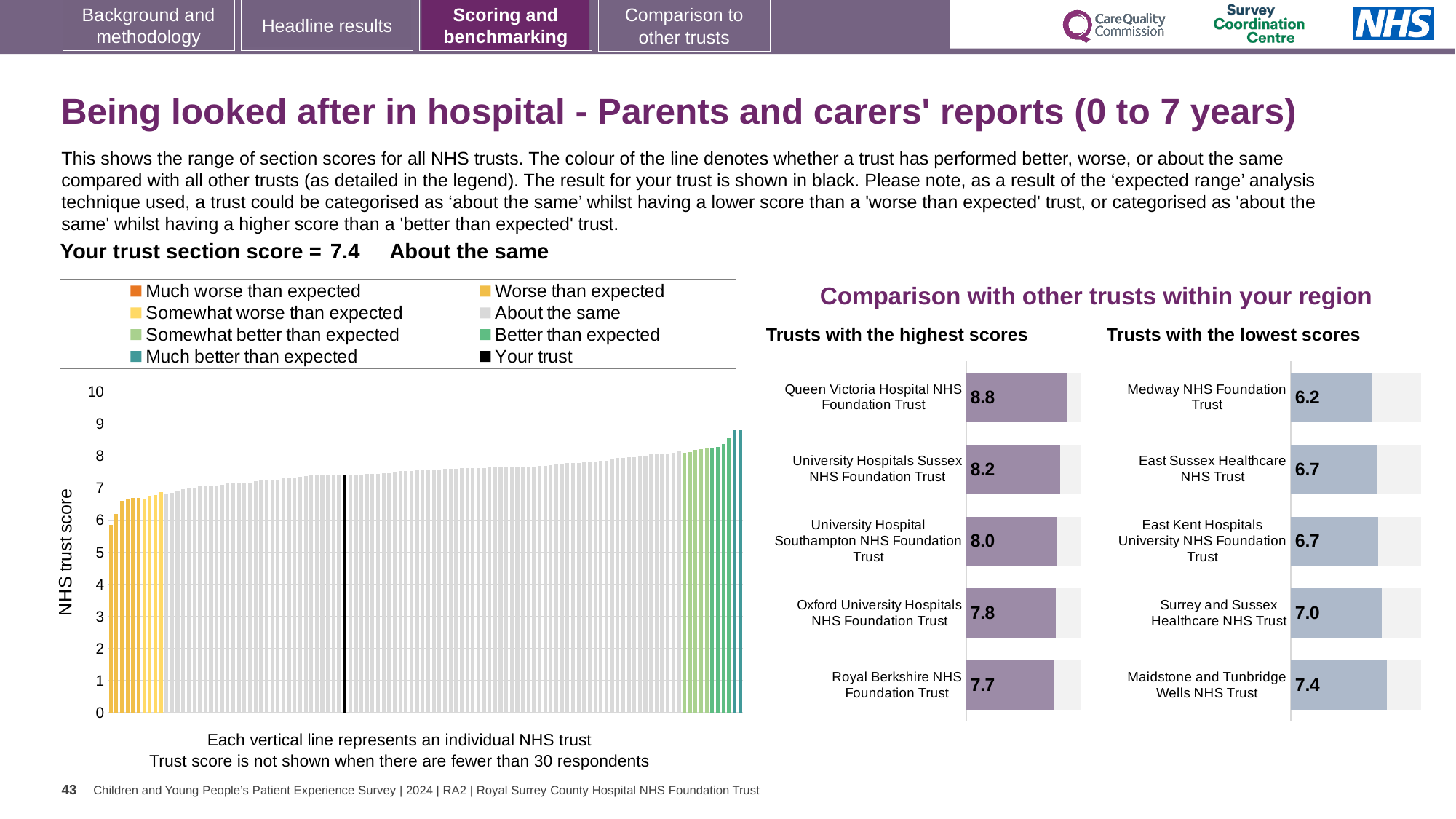
In the 'Trusts with the highest scores' chart, what is the score for Queen Victoria Hospital NHS Foundation Trust? 8.8 In the NHS trust score chart on the left, what is the section score for your trust (the black line)? 7.4 How many entries does the legend of the NHS trust score chart on the left list? 8 In the 'Trusts with the lowest scores' chart, what is the score for East Kent Hospitals University NHS Foundation Trust? 6.7 In the 'Trusts with the lowest scores' chart, what is the score for Medway NHS Foundation Trust? 6.2 What kind of chart is the NHS trust score chart on the left? bar chart In the 'Trusts with the highest scores' chart, what is the difference between the scores of Queen Victoria Hospital NHS Foundation Trust and Oxford University Hospitals NHS Foundation Trust? 1.0 In the 'Trusts with the lowest scores' chart, which has the larger score: Medway NHS Foundation Trust or Surrey and Sussex Healthcare NHS Trust? Surrey and Sussex Healthcare NHS Trust In the NHS trust score chart on the left, do the trust scores rise or fall from left to right? rise How many trusts are shown in the 'Trusts with the highest scores' chart? 5 In the 'Trusts with the highest scores' chart, which trust has the lowest score? Royal Berkshire NHS Foundation Trust In the 'Trusts with the lowest scores' chart, which trust has the highest score? Maidstone and Tunbridge Wells NHS Trust